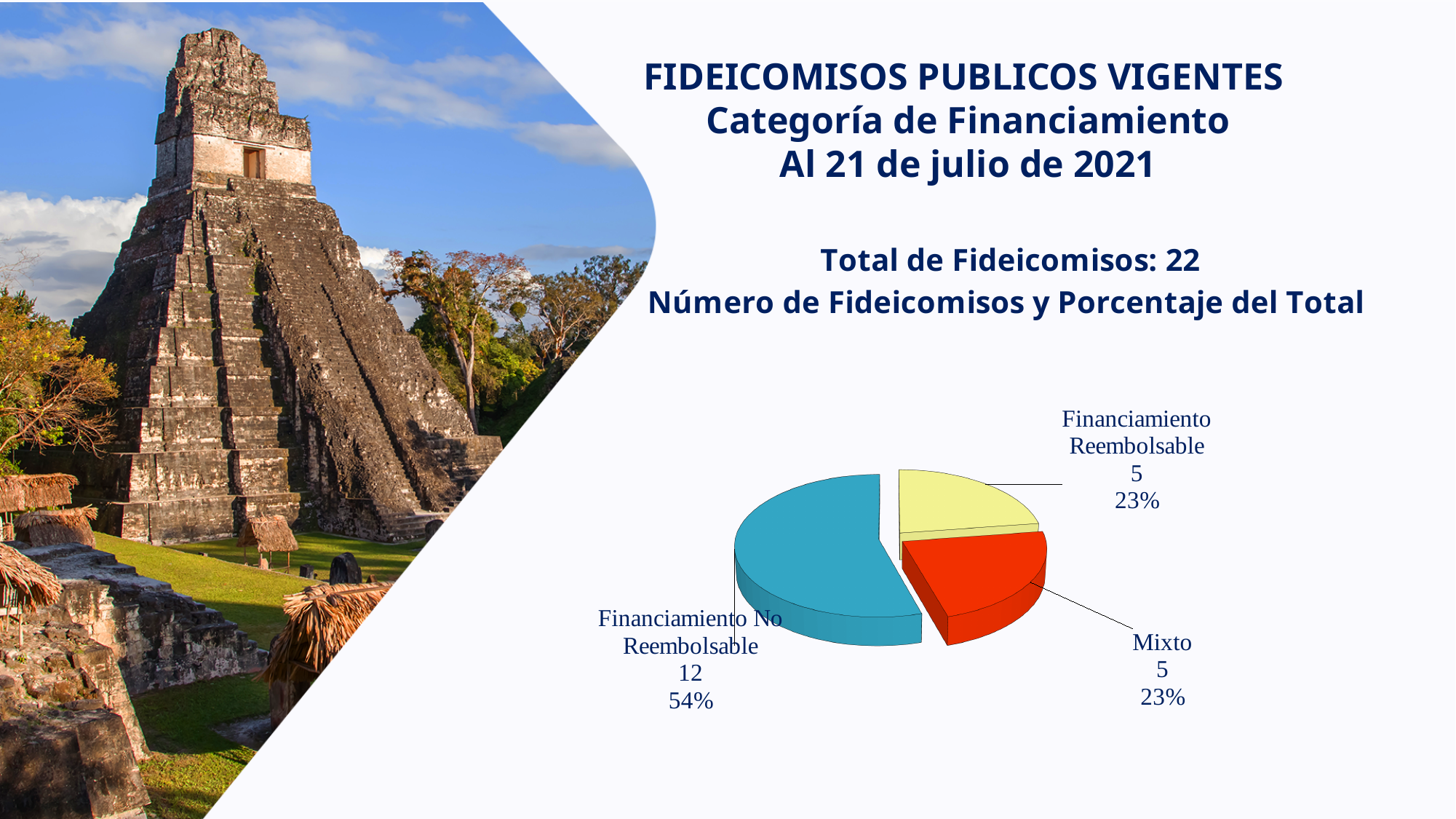
What percentage of the total does Financiamiento Reembolsable represent? 23% As of what date is the data on the slide reported? 21 de julio de 2021 Which is larger, the number of fideicomisos for Financiamiento No Reembolsable or for Financiamiento Reembolsable? Financiamiento No Reembolsable What percentage of the total does Financiamiento No Reembolsable represent? 54% How many fideicomisos are in the Mixto category? 5 How many fideicomisos are in the Financiamiento No Reembolsable category? 12 What colour is the Mixto slice of the pie chart? red What is the difference in number of fideicomisos between Financiamiento No Reembolsable and Mixto? 7 Which category has the largest slice of the pie? Financiamiento No Reembolsable What kind of chart is shown on the slide? pie chart What is the total number of fideicomisos stated on the slide? 22 How many slices does the pie chart have? 3